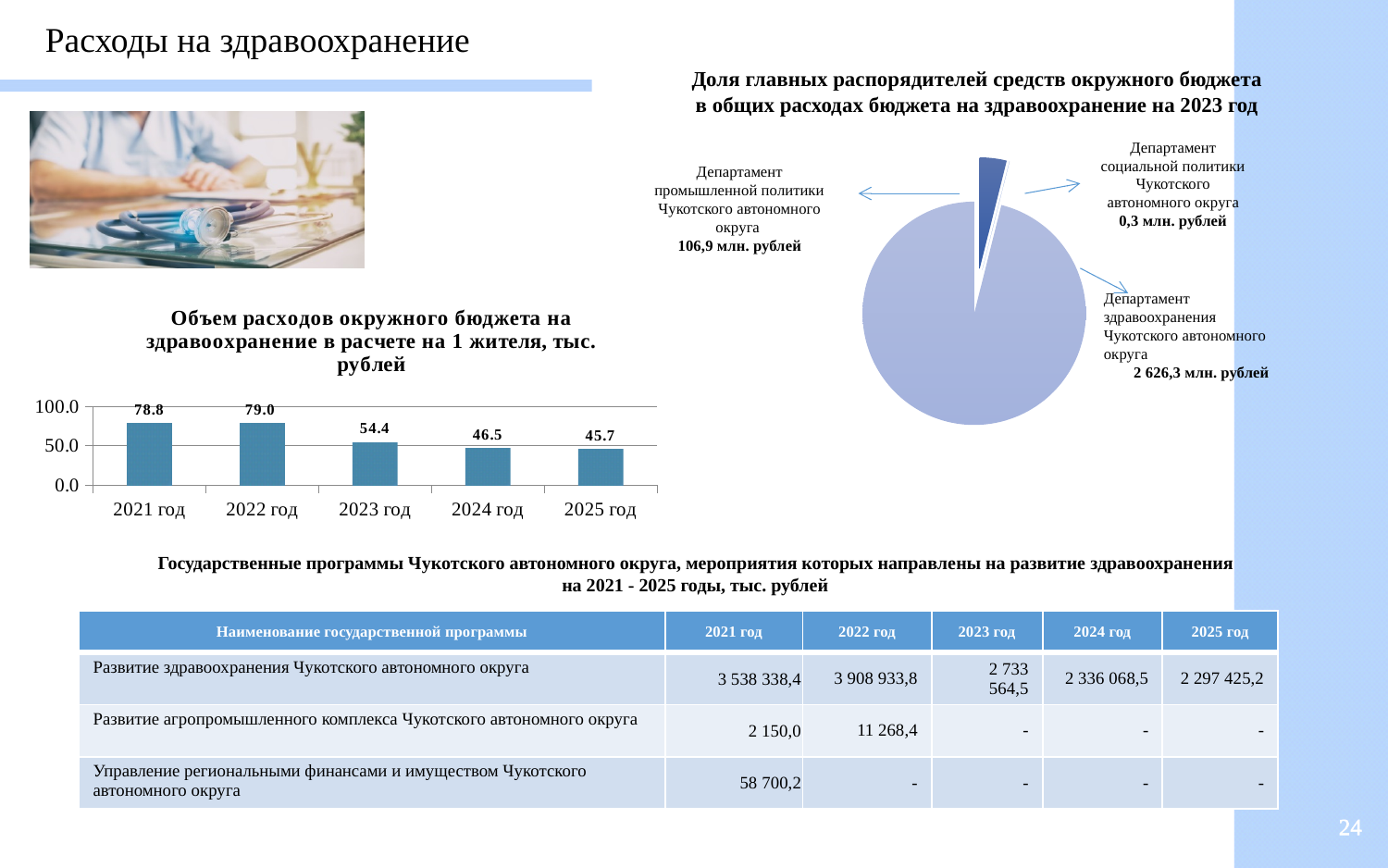
In the bar chart 'Объем расходов окружного бюджета на здравоохранение в расчете на 1 жителя, тыс. рублей', do the values generally rise or fall from 2022 год to 2025 год? fall In the pie chart 'Доля главных распорядителей средств окружного бюджета в общих расходах бюджета на здравоохранение на 2023 год', which department has the smallest slice? Департамент социальной политики Чукотского автономного округа What kind of chart is the one titled 'Объем расходов окружного бюджета на здравоохранение в расчете на 1 жителя, тыс. рублей'? bar chart In the pie chart 'Доля главных распорядителей средств окружного бюджета в общих расходах бюджета на здравоохранение на 2023 год', what is the value for Департамент здравоохранения Чукотского автономного округа? 2 626,3 млн. рублей In the bar chart 'Объем расходов окружного бюджета на здравоохранение в расчете на 1 жителя, тыс. рублей', how many years are shown? 5 In the bar chart 'Объем расходов окружного бюджета на здравоохранение в расчете на 1 жителя, тыс. рублей', which year has the highest value? 2022 год In the bar chart 'Объем расходов окружного бюджета на здравоохранение в расчете на 1 жителя, тыс. рублей', is the value for 2024 год greater or less than 50.0? less In the pie chart 'Доля главных распорядителей средств окружного бюджета в общих расходах бюджета на здравоохранение на 2023 год', how many slices are there? 3 In the bar chart 'Объем расходов окружного бюджета на здравоохранение в расчете на 1 жителя, тыс. рублей', which year has the lowest value? 2025 год In the bar chart 'Объем расходов окружного бюджета на здравоохранение в расчете на 1 жителя, тыс. рублей', what is the value for 2021 год? 78.8 In the bar chart 'Объем расходов окружного бюджета на здравоохранение в расчете на 1 жителя, тыс. рублей', what is the difference between the values for 2022 год and 2023 год? 24.6 In the bar chart 'Объем расходов окружного бюджета на здравоохранение в расчете на 1 жителя, тыс. рублей', what is the value for 2023 год? 54.4